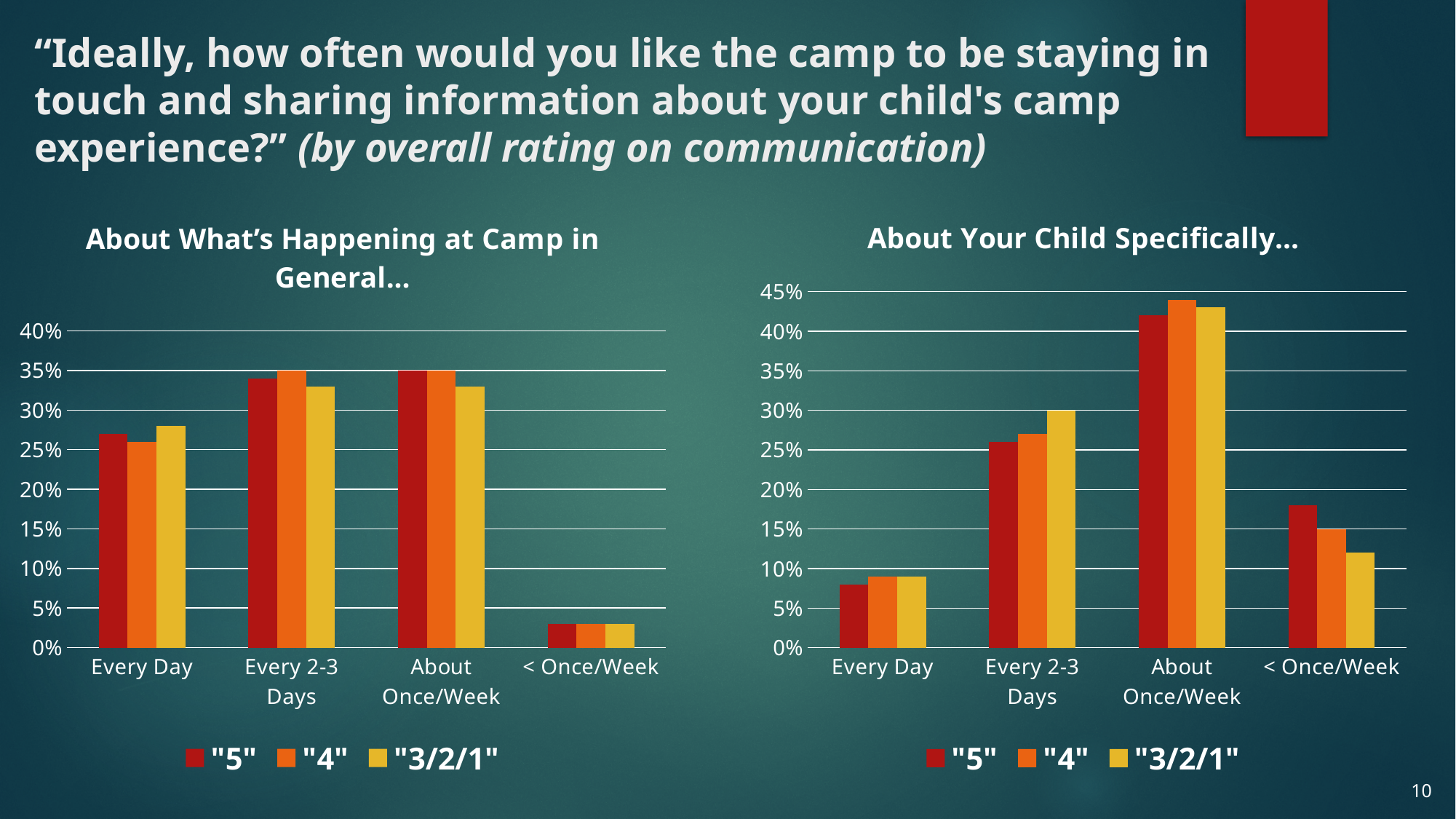
What is the title of the right chart on the slide? About Your Child Specifically… In the left chart, 'About What's Happening at Camp in General…', is the value of the "3/2/1" series for < Once/Week greater or less than 5%? less How many categories are shown on the x axis of the left chart, 'About What's Happening at Camp in General…'? 4 In the left chart, 'About What's Happening at Camp in General…', is the value of the "5" series for Every Day greater or less than 25%? greater How many series does the legend of the right chart, 'About Your Child Specifically…', list? 3 In the left chart, 'About What's Happening at Camp in General…', what is the value of the "5" series for About Once/Week? 35% In the right chart, 'About Your Child Specifically…', is the value of the "5" series for Every Day greater or less than 10%? less In the left chart, 'About What's Happening at Camp in General…', which category has the lowest value for the "4" series? < Once/Week In the right chart, 'About Your Child Specifically…', which category has the highest value for the "5" series? About Once/Week What kind of chart is the left chart, 'About What's Happening at Camp in General…'? bar chart In the right chart, 'About Your Child Specifically…', for < Once/Week, which series is larger: "5" or "3/2/1"? "5"